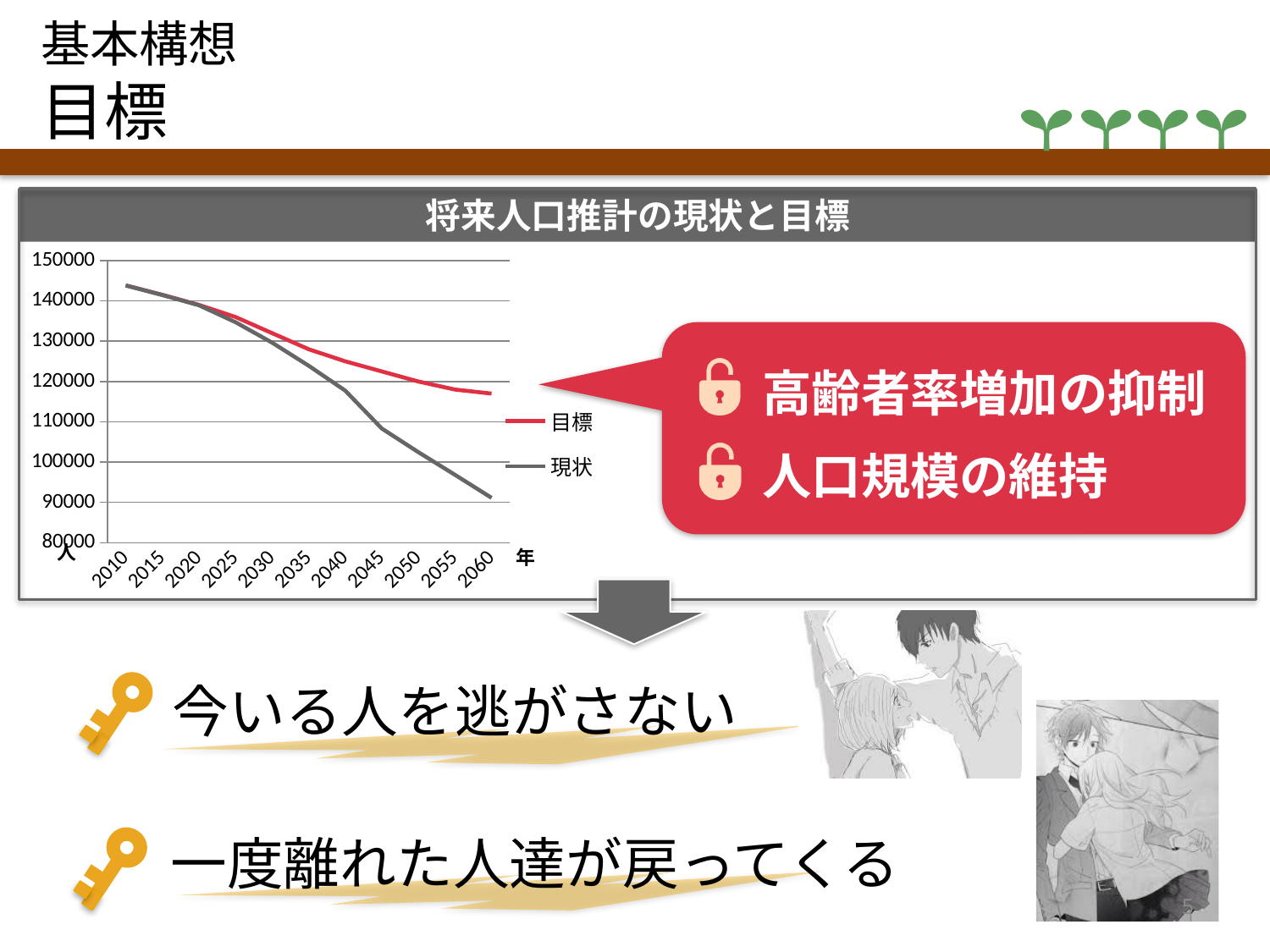
In 2050, which series has the larger value, 目標 or 現状? 目標 Is the value of 現状 in 2045 greater or less than 100000? greater Is the value of 現状 in 2060 greater or less than 100000? less What kind of chart is shown under the title 将来人口推計の現状と目標? line chart What is the title of the chart? 将来人口推計の現状と目標 How many years are marked along the x axis of the chart? 11 How many series does the legend of the chart list? 2 Which colour is used for the 目標 line in the chart? red Does the 現状 line rise or fall from 2010 to 2060? fall Does the 目標 line rise or fall from 2010 to 2060? fall Is the value of 目標 in 2060 greater or less than 110000? greater